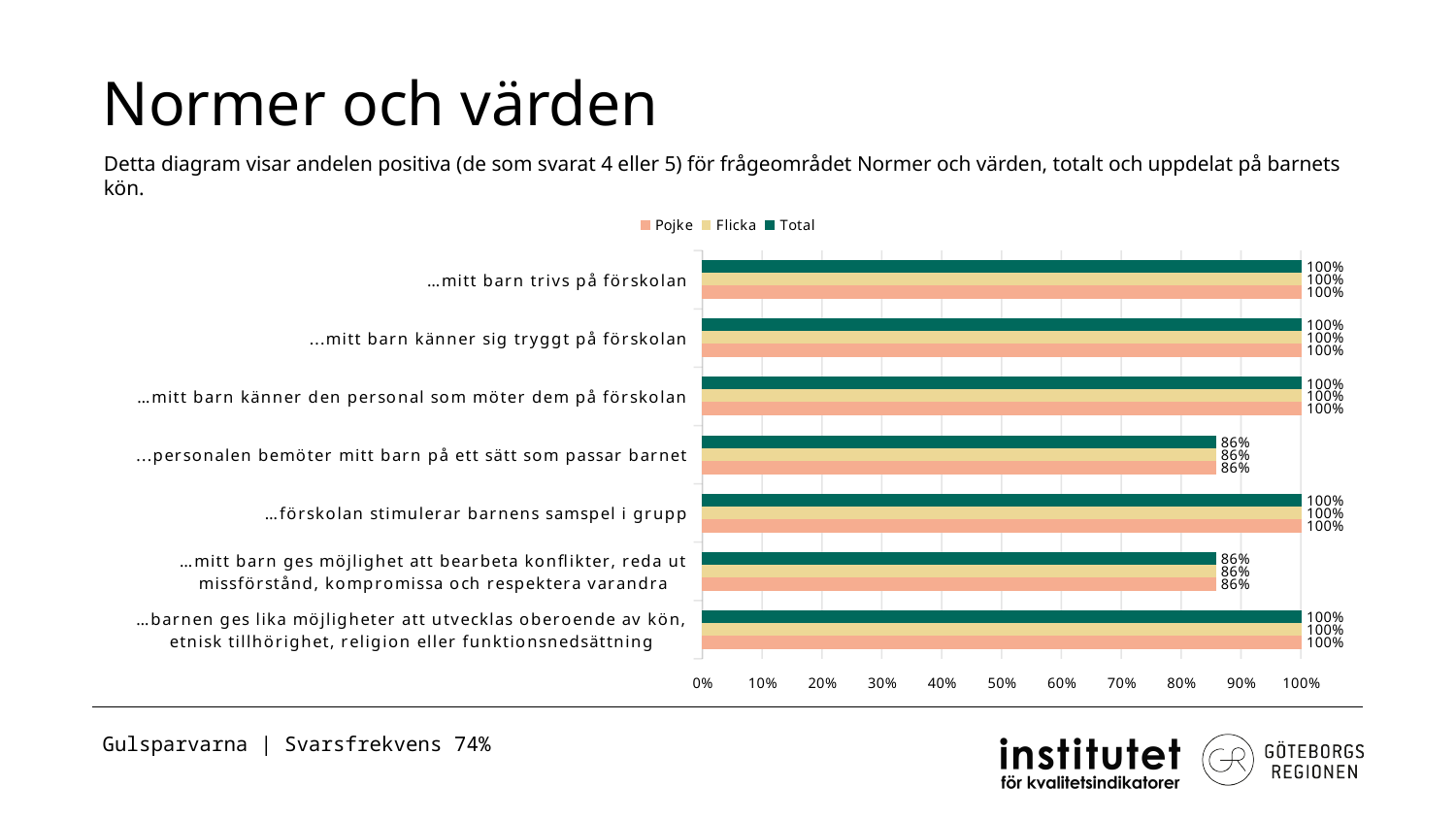
How many categories are plotted on the chart? 7 What is the Total value for "…personalen bemöter mitt barn på ett sätt som passar barnet"? 86% Which series is listed first in the legend? Pojke What is the response rate (Svarsfrekvens) shown at the bottom of the slide? 74% What is the Pojke value for "…mitt barn trivs på förskolan"? 100% What is the difference between the Total value for "…mitt barn trivs på förskolan" and the Total value for "…personalen bemöter mitt barn på ett sätt som passar barnet"? 14% Is the Total value for "…personalen bemöter mitt barn på ett sätt som passar barnet" greater or less than 90%? less What is the Total value for "…förskolan stimulerar barnens samspel i grupp"? 100% How many series does the legend list? 3 What is the Flicka value for "…mitt barn ges möjlighet att bearbeta konflikter, reda ut missförstånd, kompromissa och respektera varandra"? 86% What kind of chart is shown on the slide? bar chart Which is larger: the Pojke value for "…förskolan stimulerar barnens samspel i grupp" or the Pojke value for "…personalen bemöter mitt barn på ett sätt som passar barnet"? …förskolan stimulerar barnens samspel i grupp